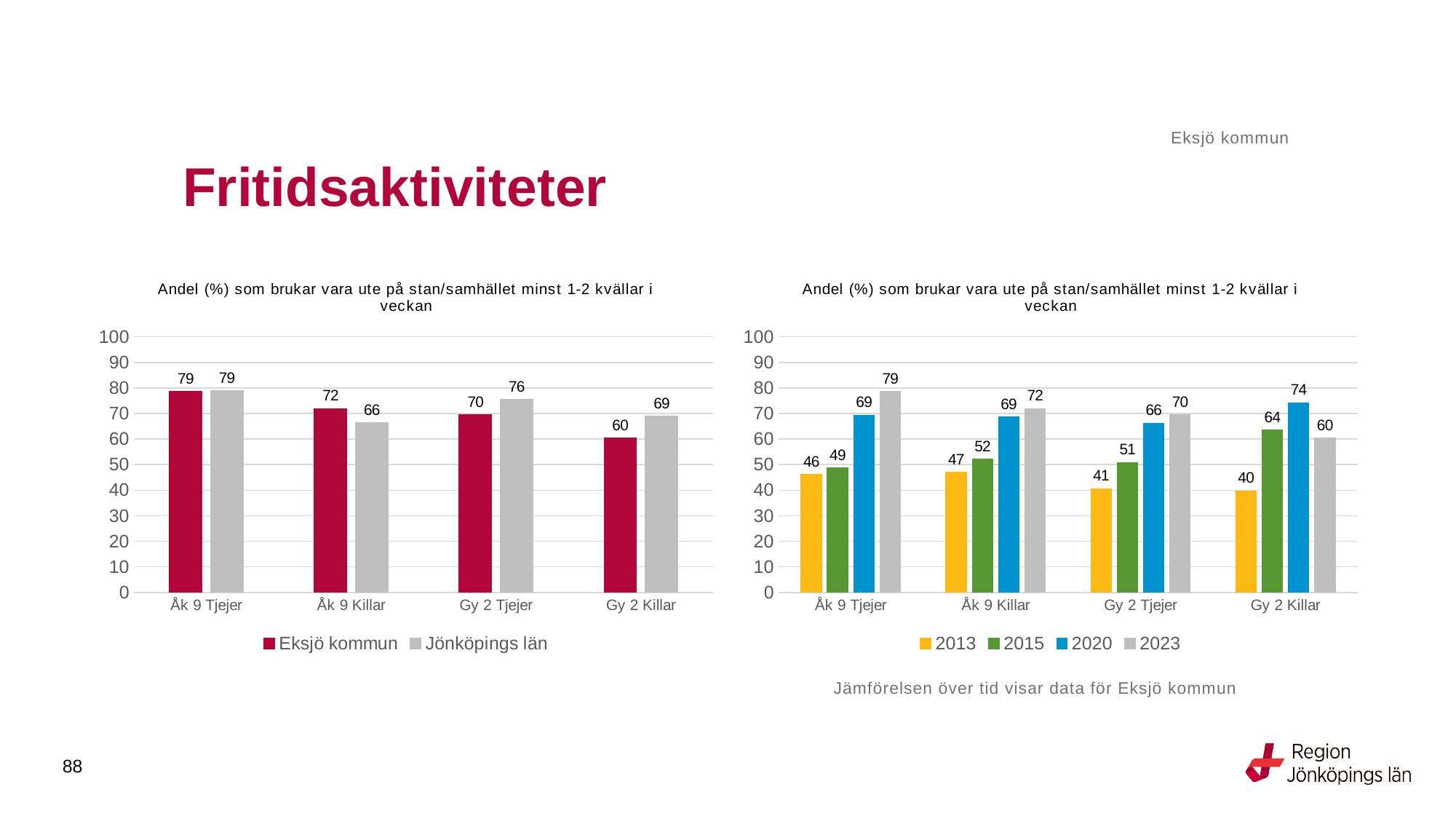
In the right chart, what is the value for 2020 for Gy 2 Killar? 74 In the right chart, for Gy 2 Killar, which is larger: the 2020 value or the 2023 value? 2020 In the right chart, what is the difference between the 2023 and 2013 values for Åk 9 Tjejer? 33 What kind of chart is the left chart? Bar chart In the right chart, what is the value for 2013 for Gy 2 Tjejer? 41 In the left chart, how many series does the legend list? 2 In the right chart, which category has the highest value for 2023? Åk 9 Tjejer In the left chart, what is the value for Jönköpings län for Gy 2 Tjejer? 76 In the left chart, which category has the lowest value for Eksjö kommun? Gy 2 Killar In the left chart, what is the difference between Jönköpings län and Eksjö kommun for Gy 2 Killar? 9 In the right chart, how many series does the legend list? 4 In the left chart, what is the value for Eksjö kommun for Åk 9 Killar? 72